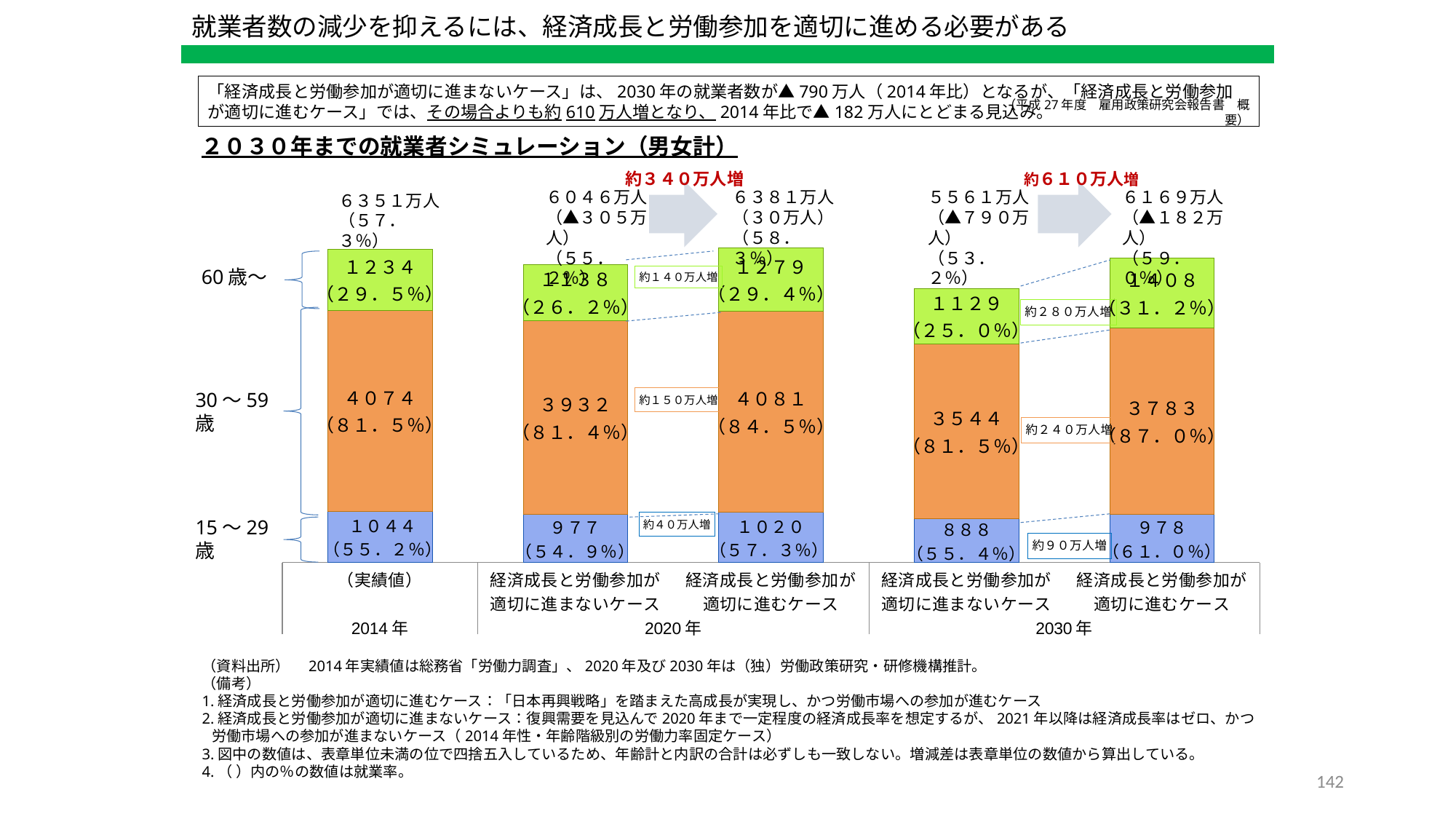
What is the value for the 30～59歳 segment in the 2014年 (実績値) bar? 4074 What kind of chart is shown on the slide? Stacked bar chart What is the difference in the 15～29歳 segment between the 2030年 適切に進むケース (978) and the 2030年 適切に進まないケース (888)? 90 What employment rate (in parentheses) is shown for the 30～59歳 segment in the 2030年 経済成長と労働参加が適切に進むケース bar? 87.0% Which bar has the highest total number of workers? 2020年 経済成長と労働参加が適切に進むケース (6381万人) What is the value for the 15～29歳 segment in the 2020年 経済成長と労働参加が適切に進まないケース bar? 977 Which is larger: the 30～59歳 segment in the 2030年 適切に進むケース or in the 2030年 適切に進まないケース? 2030年 適切に進むケース (3783) What is the value for the 60歳～ segment in the 2030年 経済成長と労働参加が適切に進むケース bar? 1408 How many age-group segments make up each stacked bar? 3 Which bar has the lowest total number of workers? 2030年 経済成長と労働参加が適切に進まないケース (5561万人) How many bars are plotted in the chart? 5 What is the total number of workers shown for the 2030年 経済成長と労働参加が適切に進まないケース bar? 5561万人